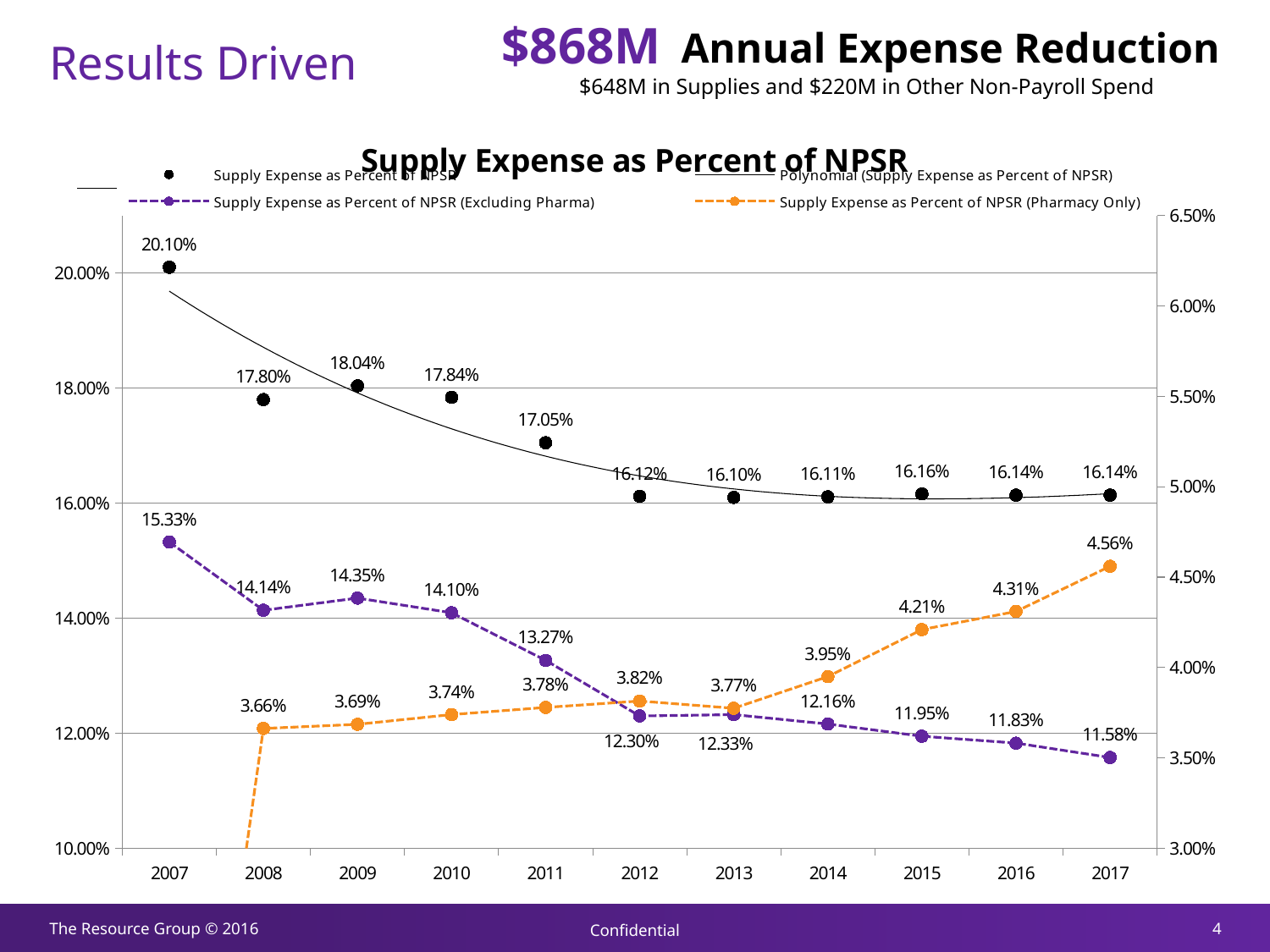
How many entries does the legend list? 4 In which year is the Supply Expense as Percent of NPSR (Excluding Pharma) series lowest? 2017 What kind of chart is shown on the slide? Line chart What is the Supply Expense as Percent of NPSR value for 2007? 20.10% Does the Supply Expense as Percent of NPSR (Pharmacy Only) series generally rise or fall from 2008 to 2017? Rise How many years are shown on the x axis? 11 What is the Supply Expense as Percent of NPSR (Pharmacy Only) value for 2017? 4.56% What is the Supply Expense as Percent of NPSR (Excluding Pharma) value for 2011? 13.27% In which year is the Supply Expense as Percent of NPSR (Pharmacy Only) series highest? 2017 For the Excluding Pharma series, which year has the larger value, 2008 or 2009? 2009 What is the title of the chart? Supply Expense as Percent of NPSR By how much did Supply Expense as Percent of NPSR fall from 2007 to 2017? 3.96 percentage points